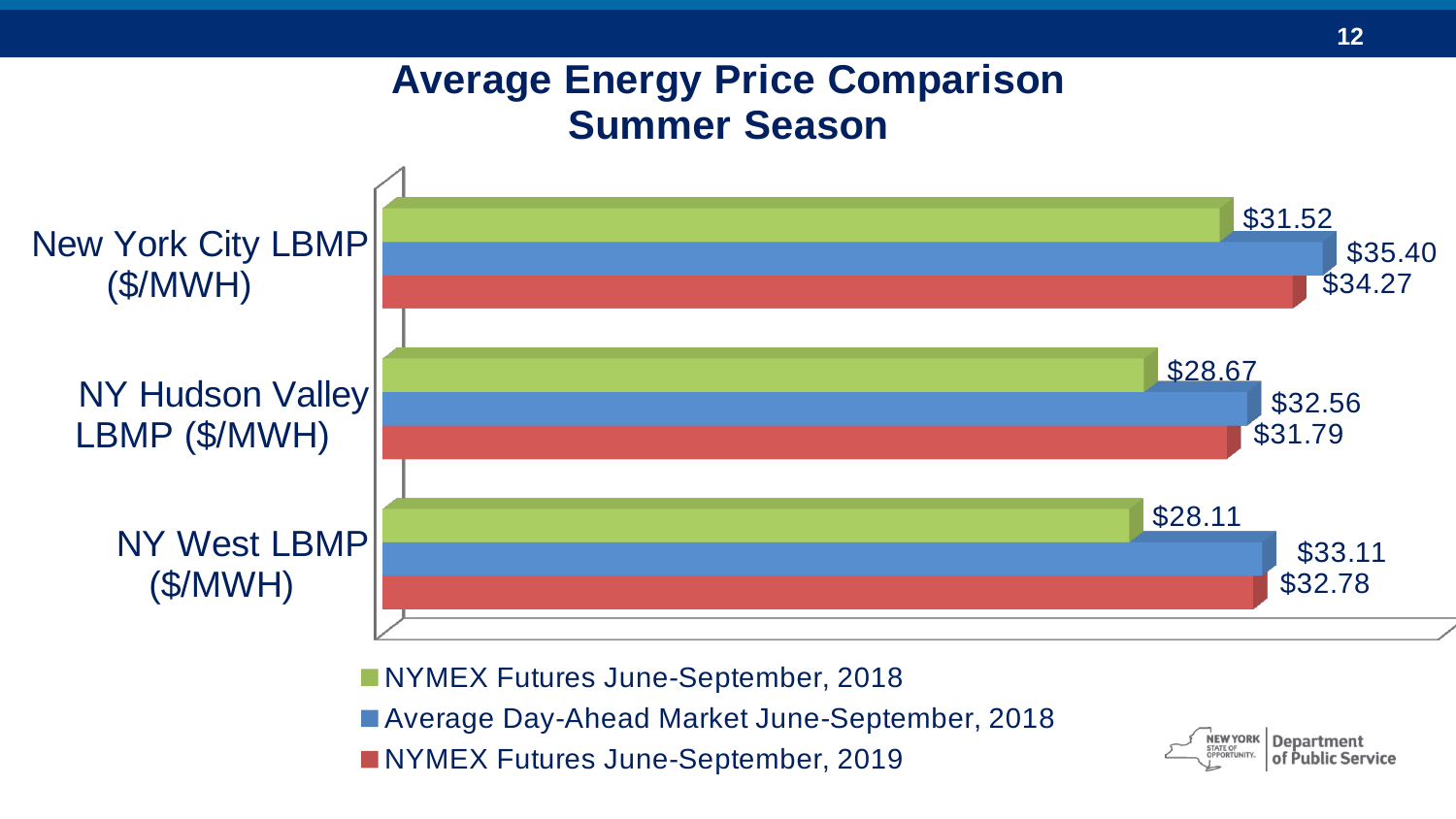
What is the NYMEX Futures June-September, 2019 value for NY West LBMP ($/MWH)? $32.78 Which category has the lowest NYMEX Futures June-September, 2018 value? NY West LBMP ($/MWH) How many series does the legend list? 3 Which is larger for NY Hudson Valley LBMP ($/MWH): the NYMEX Futures June-September, 2019 value or the NYMEX Futures June-September, 2018 value? NYMEX Futures June-September, 2019 What is the Average Day-Ahead Market June-September, 2018 value for NY Hudson Valley LBMP ($/MWH)? $32.56 Which category has the highest Average Day-Ahead Market June-September, 2018 value? New York City LBMP ($/MWH) How many categories are shown on the chart? 3 What is the difference between the NYMEX Futures June-September, 2019 value and the NYMEX Futures June-September, 2018 value for NY West LBMP ($/MWH)? $4.67 What colour represents the NYMEX Futures June-September, 2019 series? Red What kind of chart is shown on the slide? Bar chart What is the difference between the Average Day-Ahead Market June-September, 2018 value and the NYMEX Futures June-September, 2018 value for New York City LBMP ($/MWH)? $3.88 What is the NYMEX Futures June-September, 2018 value for New York City LBMP ($/MWH)? $31.52